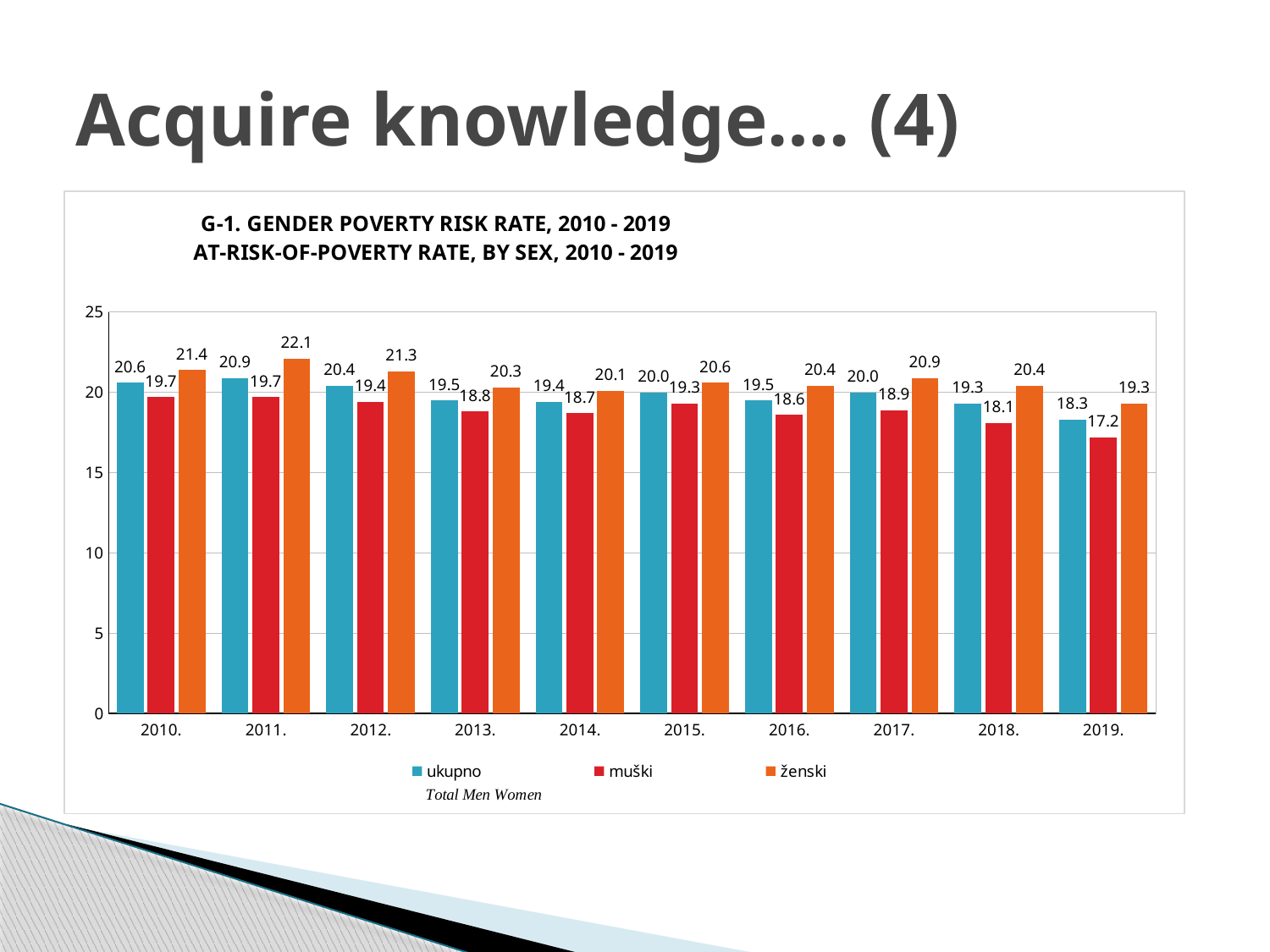
Does the ukupno (Total) value rise or fall from 2017 to 2019? fall How many series does the legend list? 3 What is the difference between the ženski (Women) and muški (Men) values in 2011? 2.4 What is the value for muški (Men) in 2019? 17.2 In which year is the ženski (Women) value highest? 2011. What is the value for ukupno (Total) in 2010? 20.6 In which year is the muški (Men) value lowest? 2019. Is the value for muški (Men) in 2018 greater or less than 20? less Which is larger in 2015: the ukupno (Total) value or the ženski (Women) value? ženski How many years are shown on the x axis? 10 What is the value for ženski (Women) in 2011? 22.1 What kind of chart is shown? bar chart